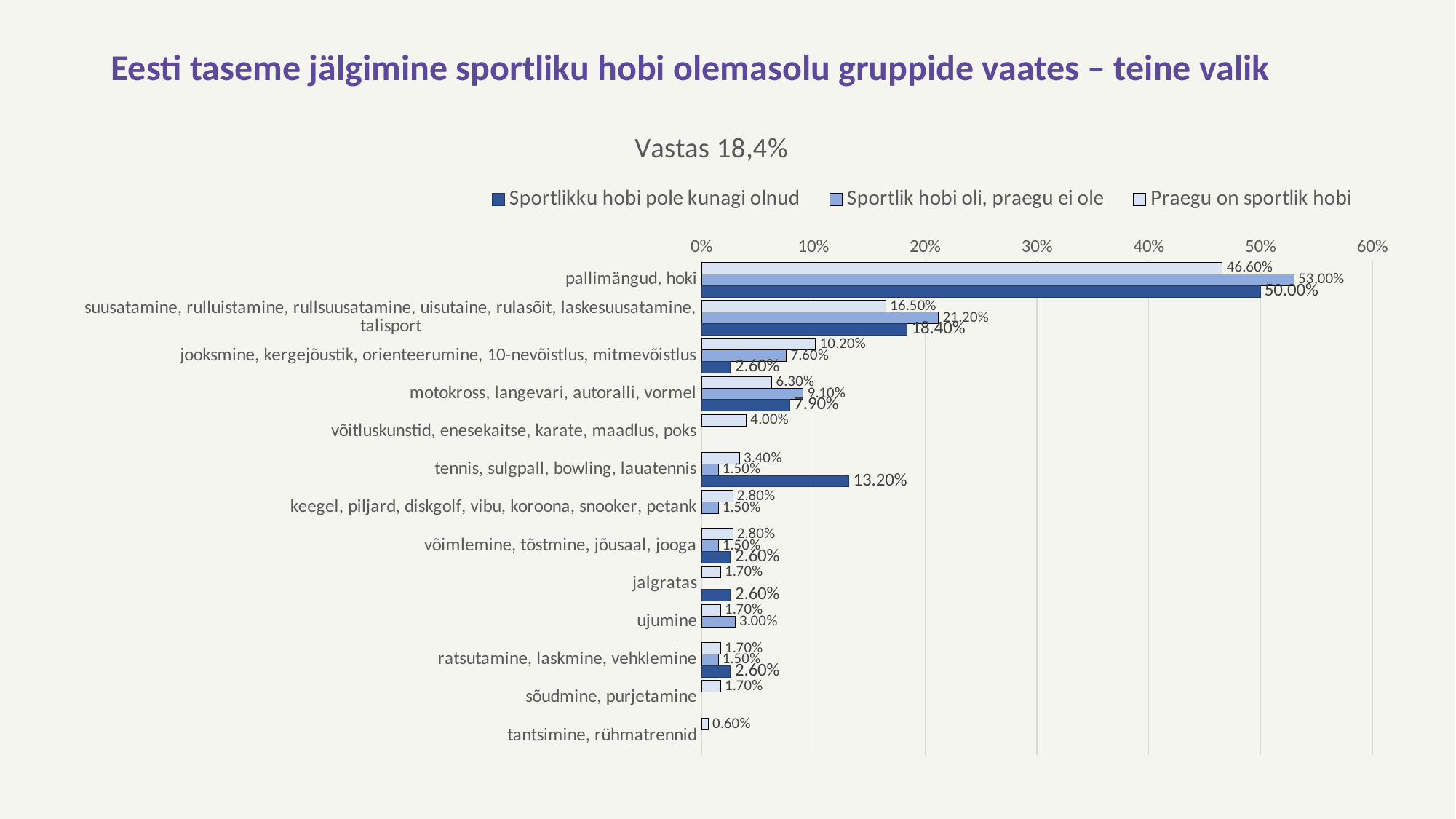
What kind of chart is shown on the slide? bar chart What is the value for "jooksmine, kergejõustik, orienteerumine, 10-nevõistlus, mitmevõistlus" in the "Praegu on sportlik hobi" series? 10.20% Is the value for "suusatamine, rulluistamine, rullsuusatamine, uisutaine, rulasõit, laskesuusatamine, talisport" in the "Sportlik hobi oli, praegu ei ole" series greater or less than 20%? greater What is the value for "tantsimine, rühmatrennid" in the "Praegu on sportlik hobi" series? 0.60% What is the value for "pallimängud, hoki" in the "Sportlik hobi oli, praegu ei ole" series? 53.00% How many series does the legend list? 3 What is the difference between the "Sportlik hobi oli, praegu ei ole" and "Praegu on sportlik hobi" values for "pallimängud, hoki"? 6.40% What is the value for "tennis, sulgpall, bowling, lauatennis" in the "Sportlikku hobi pole kunagi olnud" series? 13.20% Which category has the highest value in the "Sportlikku hobi pole kunagi olnud" series? pallimängud, hoki For "motokross, langevari, autoralli, vormel", which series has the larger value: "Sportlik hobi oli, praegu ei ole" or "Praegu on sportlik hobi"? Sportlik hobi oli, praegu ei ole How many categories are shown on the chart? 13 What is the title of the chart? Vastas 18,4%